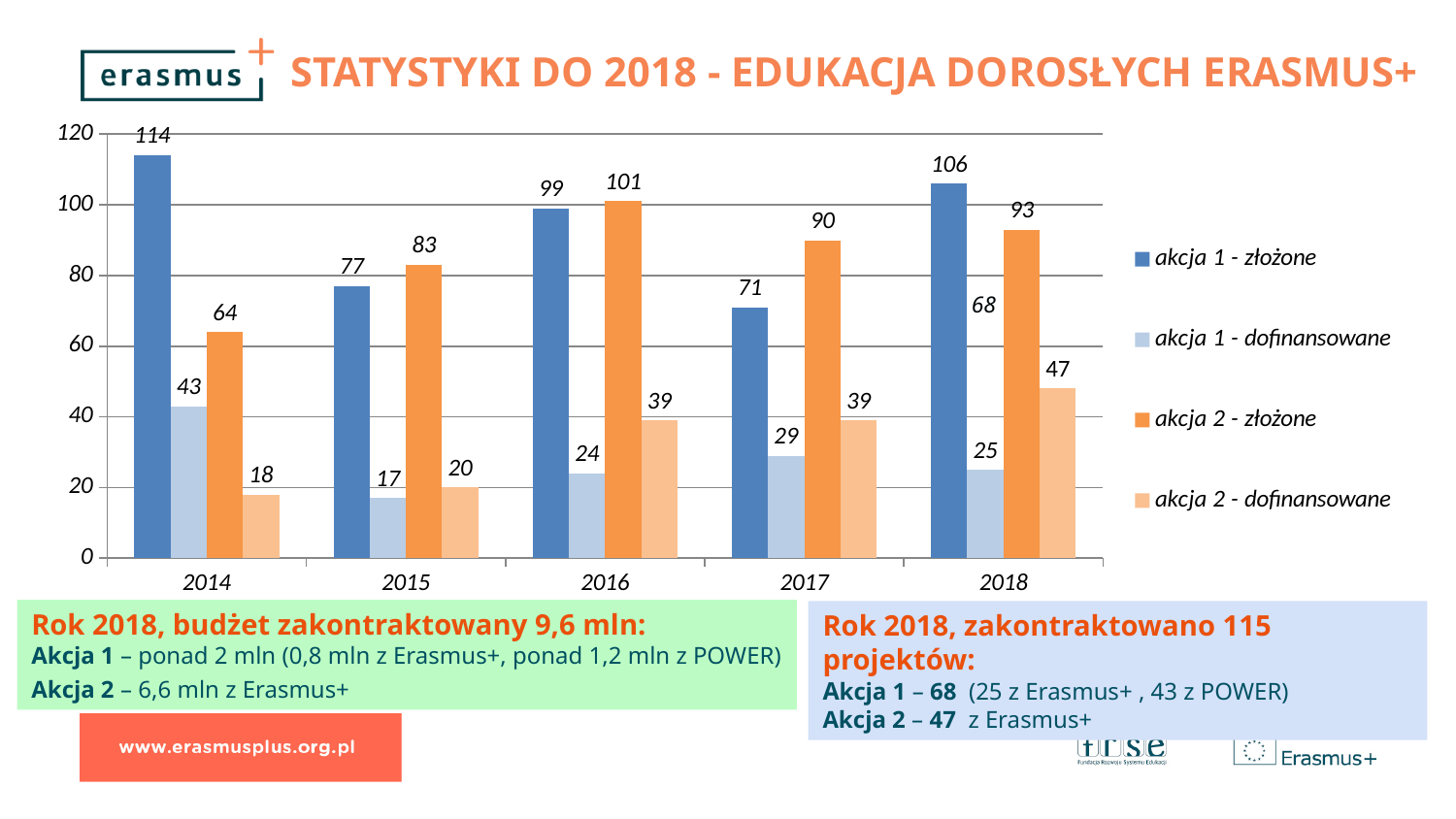
How many years are shown on the x axis? 5 What kind of chart is shown on the slide? bar chart How many series does the legend list? 4 What is the difference between 'akcja 1 - złożone' and 'akcja 1 - dofinansowane' in 2017? 42 What is the value for 'akcja 1 - złożone' in 2014? 114 What is the value for 'akcja 1 - dofinansowane' in 2018? 25 In which year is 'akcja 2 - złożone' highest? 2016 Does 'akcja 2 - dofinansowane' rise or fall from 2014 to 2016? rise Which is larger in 2015: 'akcja 1 - złożone' or 'akcja 2 - złożone'? akcja 2 - złożone In which year is 'akcja 1 - dofinansowane' lowest? 2015 What is the value for 'akcja 2 - dofinansowane' in 2016? 39 What colour are the bars for 'akcja 2 - złożone'? orange